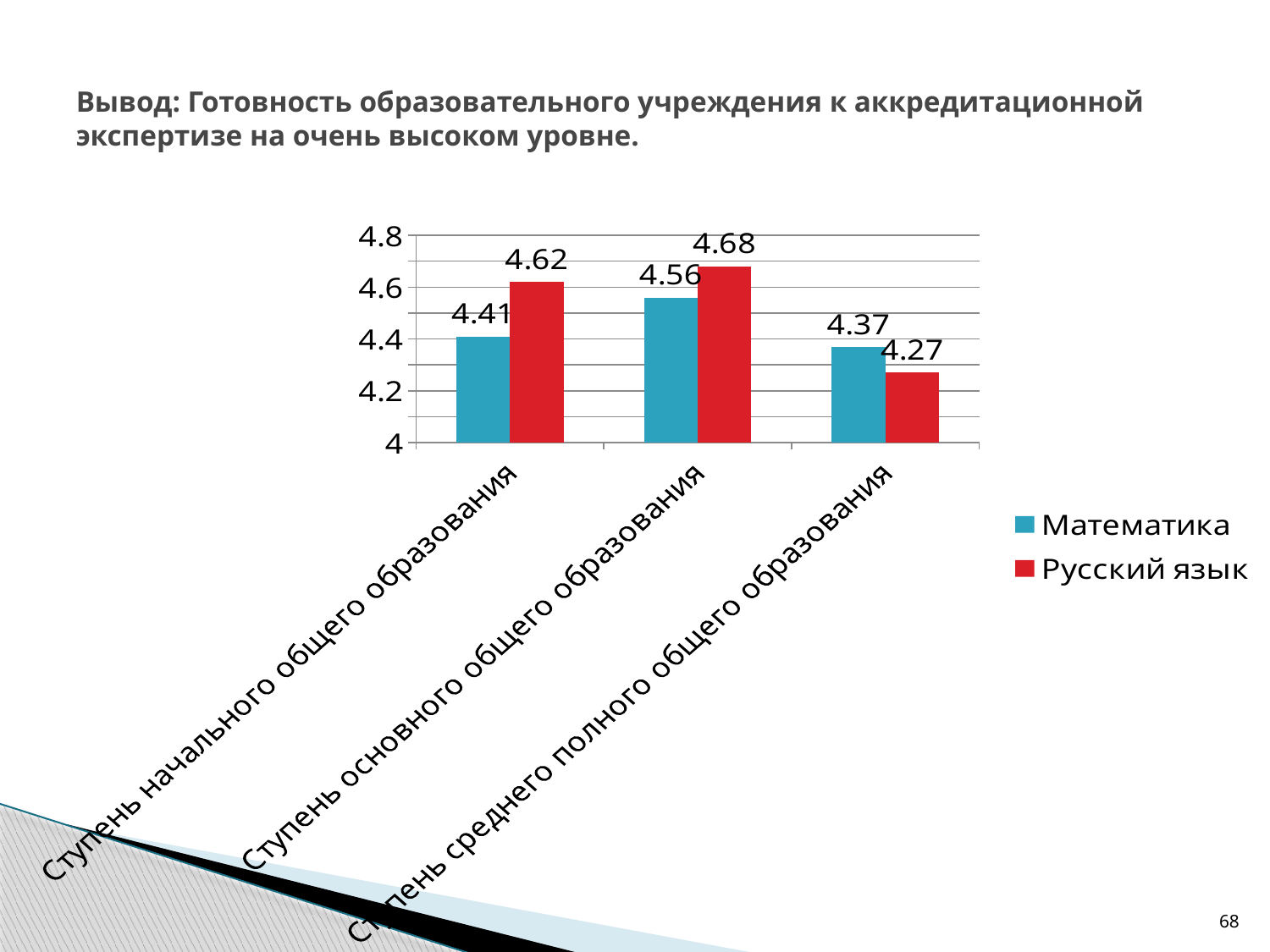
What kind of chart is shown on the slide? bar chart How many categories are shown on the x axis? 3 Which category has the highest value for Математика? Ступень основного общего образования Which colour represents Русский язык in the legend? red Is the value for Математика at Ступень основного общего образования greater or less than 4.4? greater What is the value for Математика at Ступень начального общего образования? 4.41 Which category has the lowest value for Русский язык? Ступень среднего полного общего образования What is the value for Русский язык at Ступень основного общего образования? 4.68 How many series does the legend list? 2 Which is larger at Ступень среднего полного общего образования, Математика or Русский язык? Математика What is the difference between Русский язык and Математика at Ступень начального общего образования? 0.21 What is the value for Русский язык at Ступень среднего полного общего образования? 4.27